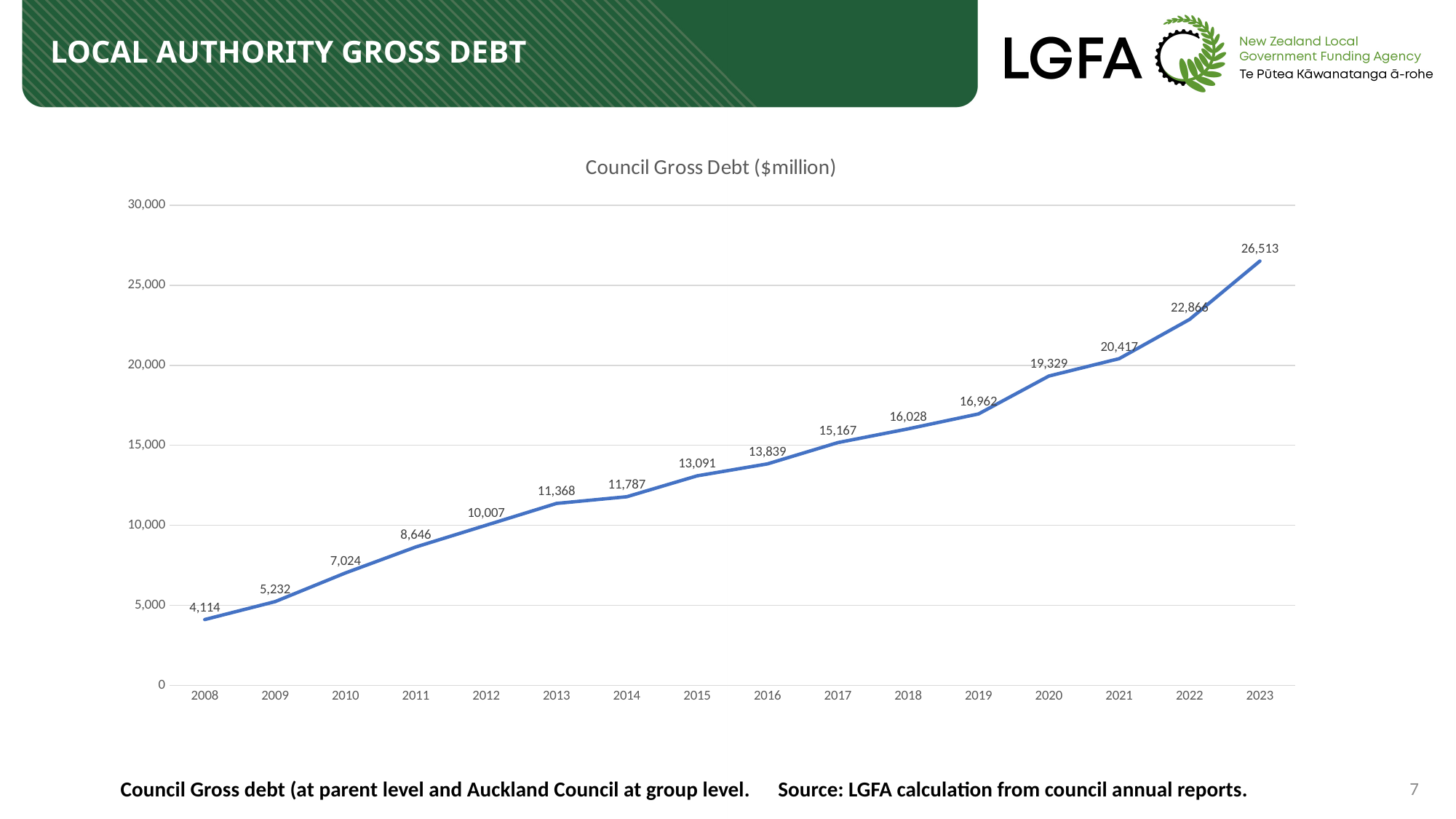
Which year has the lowest council gross debt? 2008 What is the council gross debt value for 2020? 19,329 How many years are plotted on the x axis? 16 What is the council gross debt value for 2015? 13,091 What is the difference between the council gross debt in 2013 and in 2012? 1,361 What is the difference between the council gross debt in 2023 and in 2022? 3,647 Which is larger, the council gross debt in 2018 or in 2019? 2019 Do the council gross debt values rise or fall from 2008 to 2023? Rise What is the council gross debt value for 2008? 4,114 What kind of chart is shown on the slide? Line chart Is the council gross debt value for 2021 greater or less than 20,000? greater Which year has the highest council gross debt? 2023